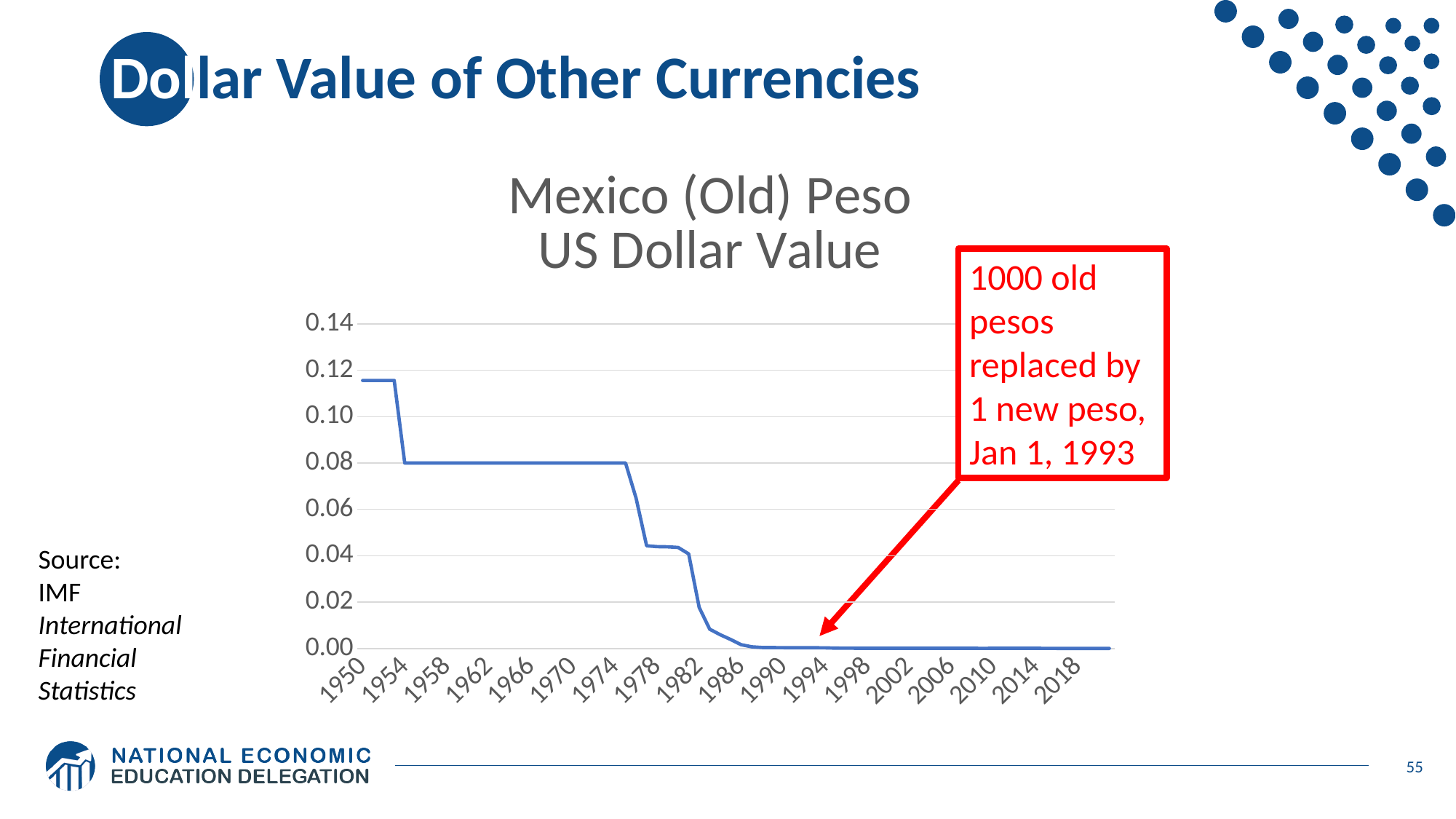
Is the value for 1954 greater or less than 0.10? less Which year has a higher value, 1950 or 1982? 1950 Do the values in the chart generally rise or fall from 1950 to 2018? fall What kind of chart is shown on the slide? line chart Is the value for 1966 greater or less than 0.06? greater Which year has a higher value, 1970 or 1978? 1970 According to the annotation on the chart, on what date were 1000 old pesos replaced by 1 new peso? Jan 1, 1993 What is the title of the chart? Mexico (Old) Peso US Dollar Value Is the value for 1950 greater or less than 0.10? greater How many year labels are shown on the x axis? 18